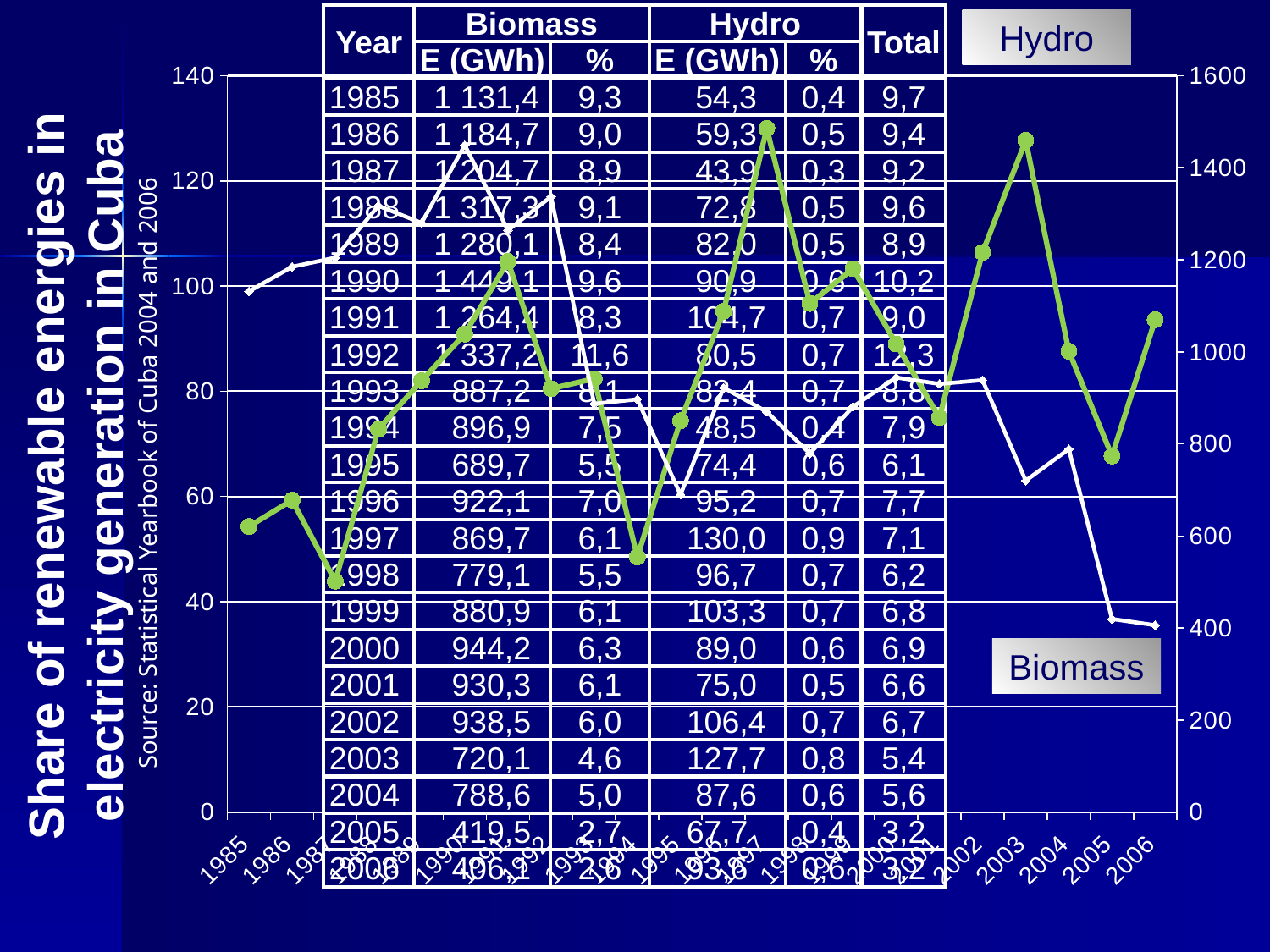
How many years are shown along the x axis of the chart? 22 Is the Biomass value for 2005 greater or less than 600? less Does the Biomass series overall rise or fall from 1985 to 2006? fall What kind of chart is shown on the slide? line chart In which year does the Biomass series reach its highest value? 1990 What is the Hydro E (GWh) value for 1997? 130,0 Is the Biomass value for 1990 greater or less than 1400? greater Which year has the larger Hydro value, 1994 or 1997? 1997 Is the Hydro value for 1997 greater or less than 120? greater What is the title of the slide's chart? Share of renewable energies in electricity generation in Cuba How many series are plotted on the chart? 2